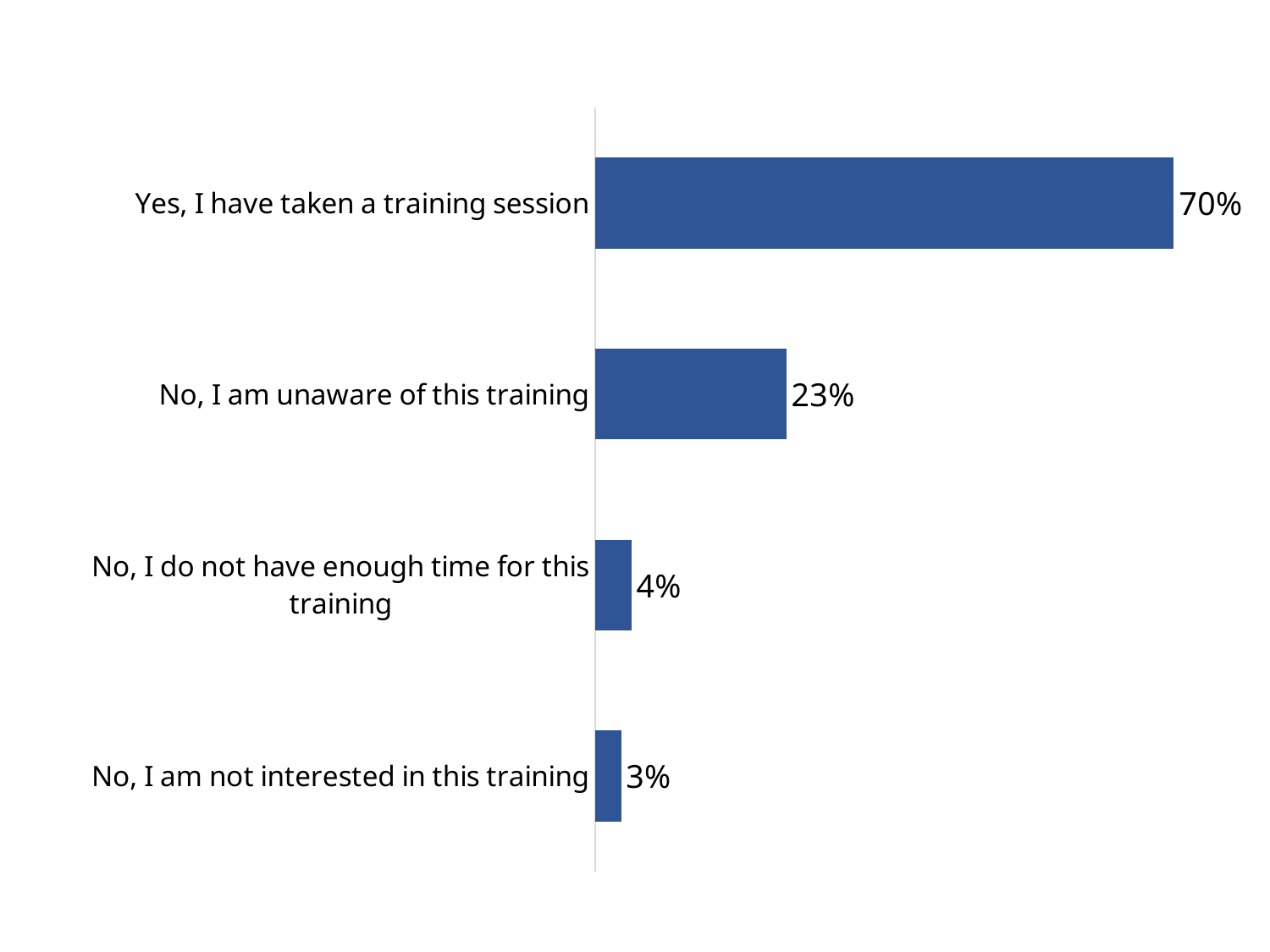
Which is larger: "No, I am unaware of this training" or "No, I do not have enough time for this training"? No, I am unaware of this training Which category has the lowest value? No, I am not interested in this training What colour are the bars in the chart? Blue What percentage of respondents said "Yes, I have taken a training session"? 70% What is the difference between "No, I do not have enough time for this training" and "No, I am not interested in this training"? 1% What is the difference between "Yes, I have taken a training session" and "No, I am unaware of this training"? 47% What kind of chart is shown on the slide? Bar chart How many categories are shown in the chart? 4 Which category has the highest value? Yes, I have taken a training session What is the value for "No, I am unaware of this training"? 23% What is the value for "No, I do not have enough time for this training"? 4% What is the value for "No, I am not interested in this training"? 3%